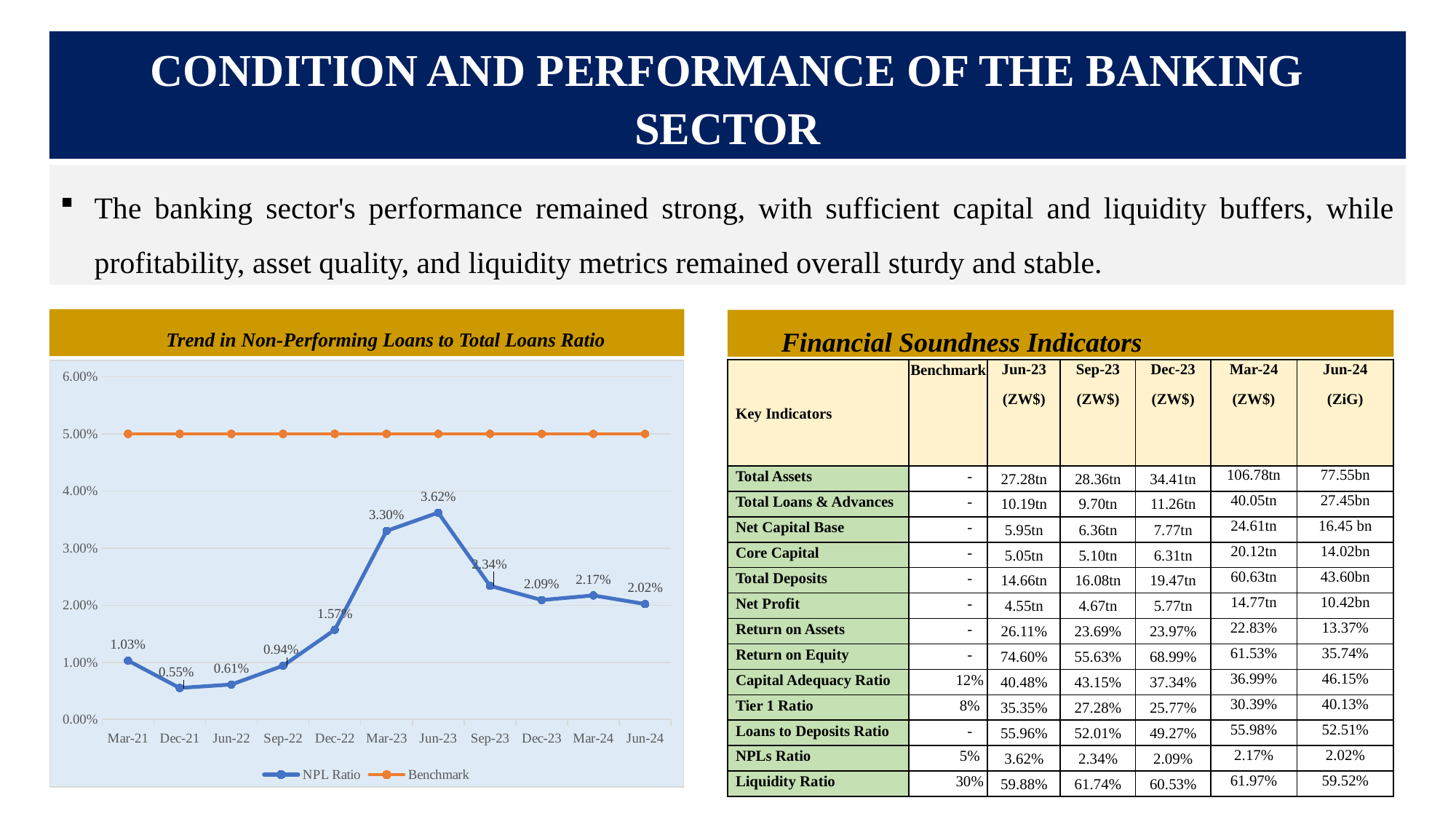
How many series does the legend of the Trend in Non-Performing Loans to Total Loans Ratio chart list? 2 What is the NPL Ratio for Jun-23 in the Trend in Non-Performing Loans to Total Loans Ratio chart? 3.62% Which period has the lowest NPL Ratio in the Trend in Non-Performing Loans to Total Loans Ratio chart? Dec-21 What is the difference between the NPL Ratio for Jun-23 and Sep-23 in the Trend in Non-Performing Loans to Total Loans Ratio chart? 1.28% What type of chart is the Trend in Non-Performing Loans to Total Loans Ratio chart? Line chart Which period has the highest NPL Ratio in the Trend in Non-Performing Loans to Total Loans Ratio chart? Jun-23 In the Trend in Non-Performing Loans to Total Loans Ratio chart, does the NPL Ratio rise or fall from Jun-23 to Jun-24? Fall How many time periods are plotted on the x axis of the Trend in Non-Performing Loans to Total Loans Ratio chart? 11 In the Trend in Non-Performing Loans to Total Loans Ratio chart, is the Benchmark value greater or less than 4.00%? greater What is the NPL Ratio for Jun-24 in the Trend in Non-Performing Loans to Total Loans Ratio chart? 2.02% In the Trend in Non-Performing Loans to Total Loans Ratio chart, is the NPL Ratio higher in Mar-23 or Dec-22? Mar-23 What is the NPL Ratio for Dec-21 in the Trend in Non-Performing Loans to Total Loans Ratio chart? 0.55%